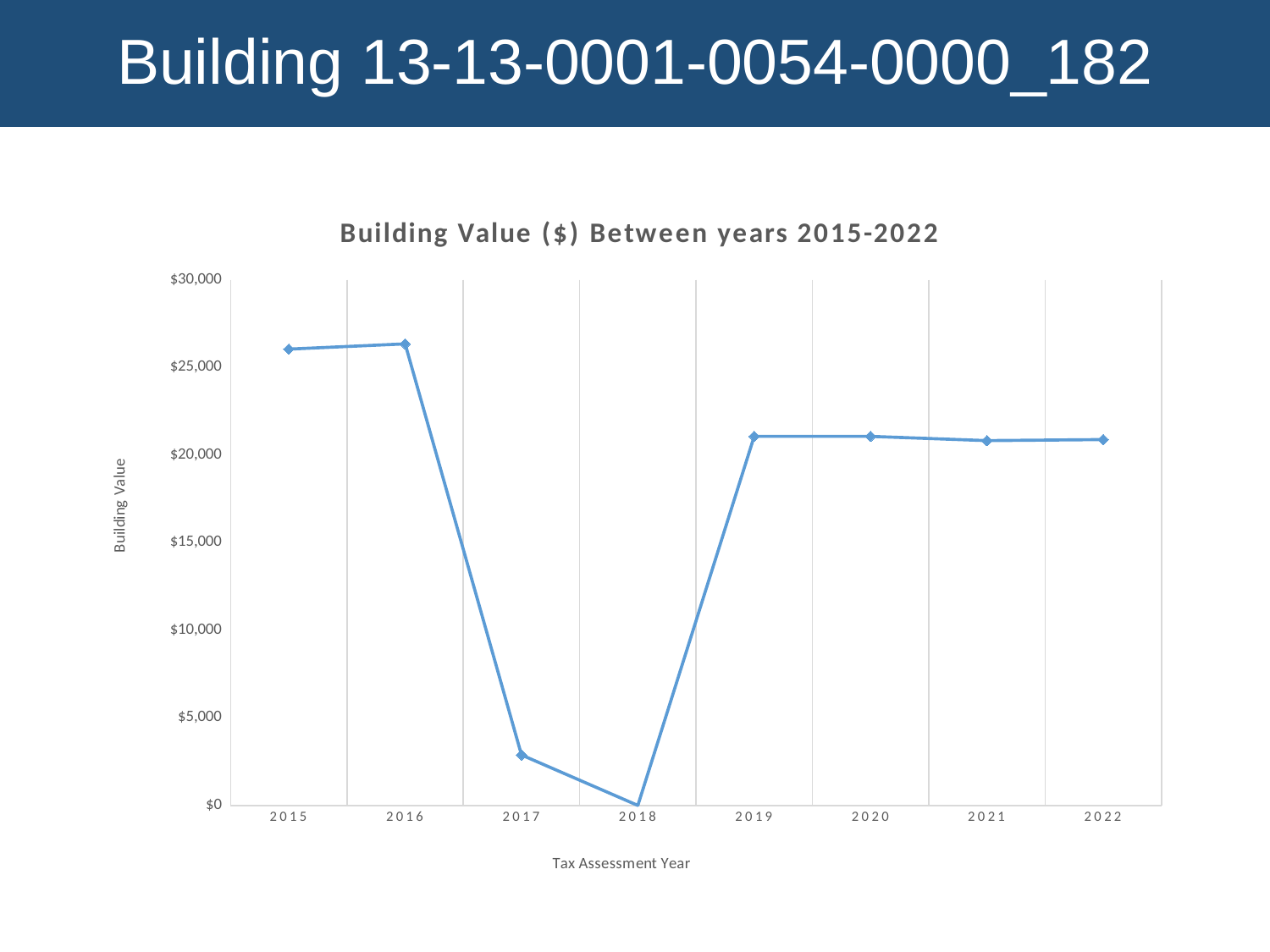
What is the title of the chart? Building Value ($) Between years 2015-2022 Which year has the larger building value, 2016 or 2017? 2016 Is the building value for 2022 greater or less than $25,000? less Is the building value for 2019 greater or less than $20,000? greater Which year has the lowest building value? 2018 Is the building value for 2017 greater or less than $5,000? less How many tax assessment years are plotted on the chart? 8 What type of chart is shown on the slide? line chart What is the building value for 2018? $0 Does the building value rise or fall from 2016 to 2018? fall What is the label of the x axis? Tax Assessment Year